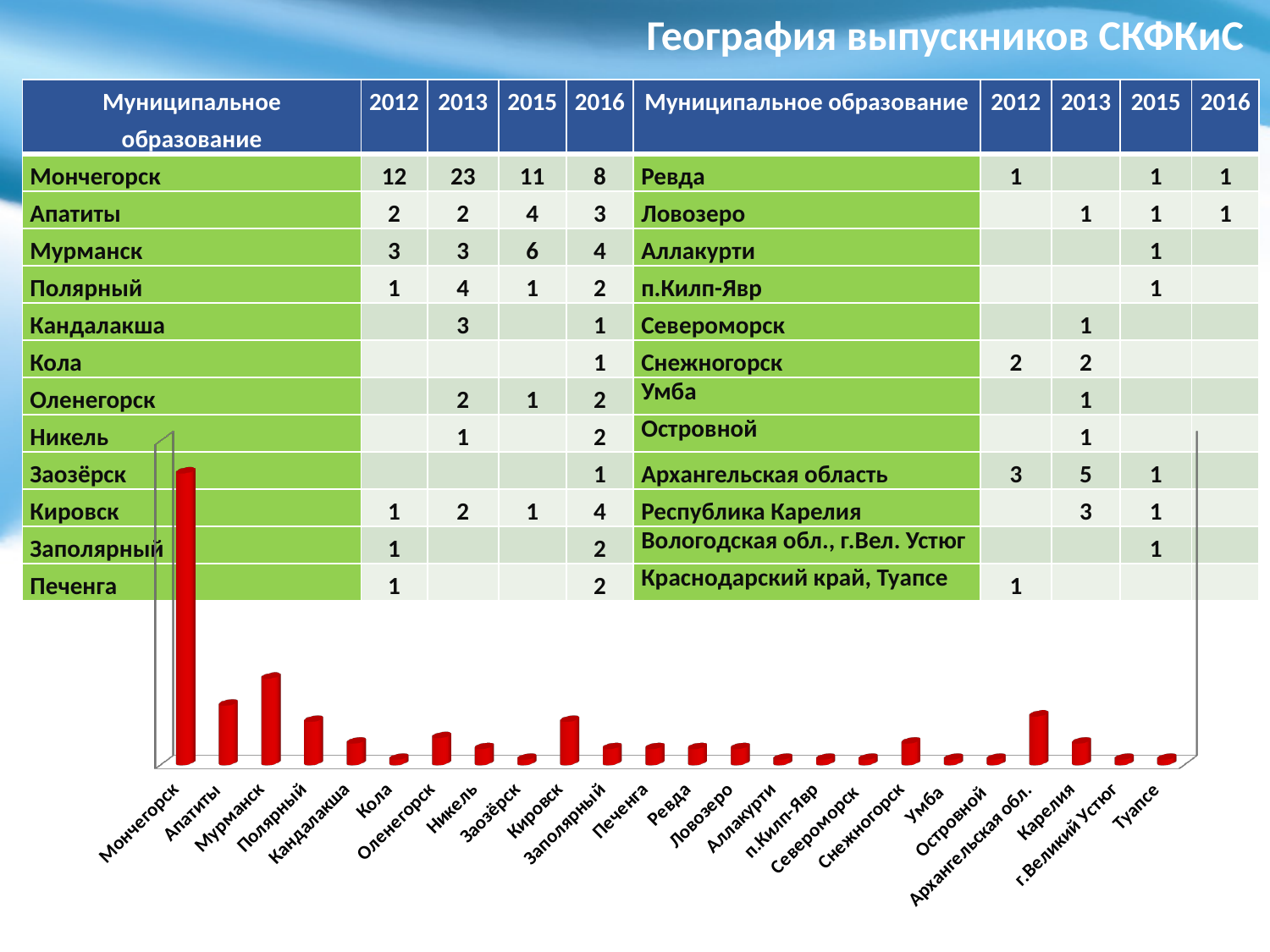
Which bar is taller in the chart, Мурманск or Апатиты? Мурманск What is the first category on the x axis of the chart? Мончегорск Which bar is taller in the chart, Апатиты or Полярный? Апатиты Which bar is taller in the chart, Архангельская обл. or Карелия? Архангельская обл. How many categories are shown along the x axis of the chart? 24 What kind of chart is shown on the slide? bar chart Which category has the highest bar in the chart? Мончегорск What colour are the bars in the chart? red